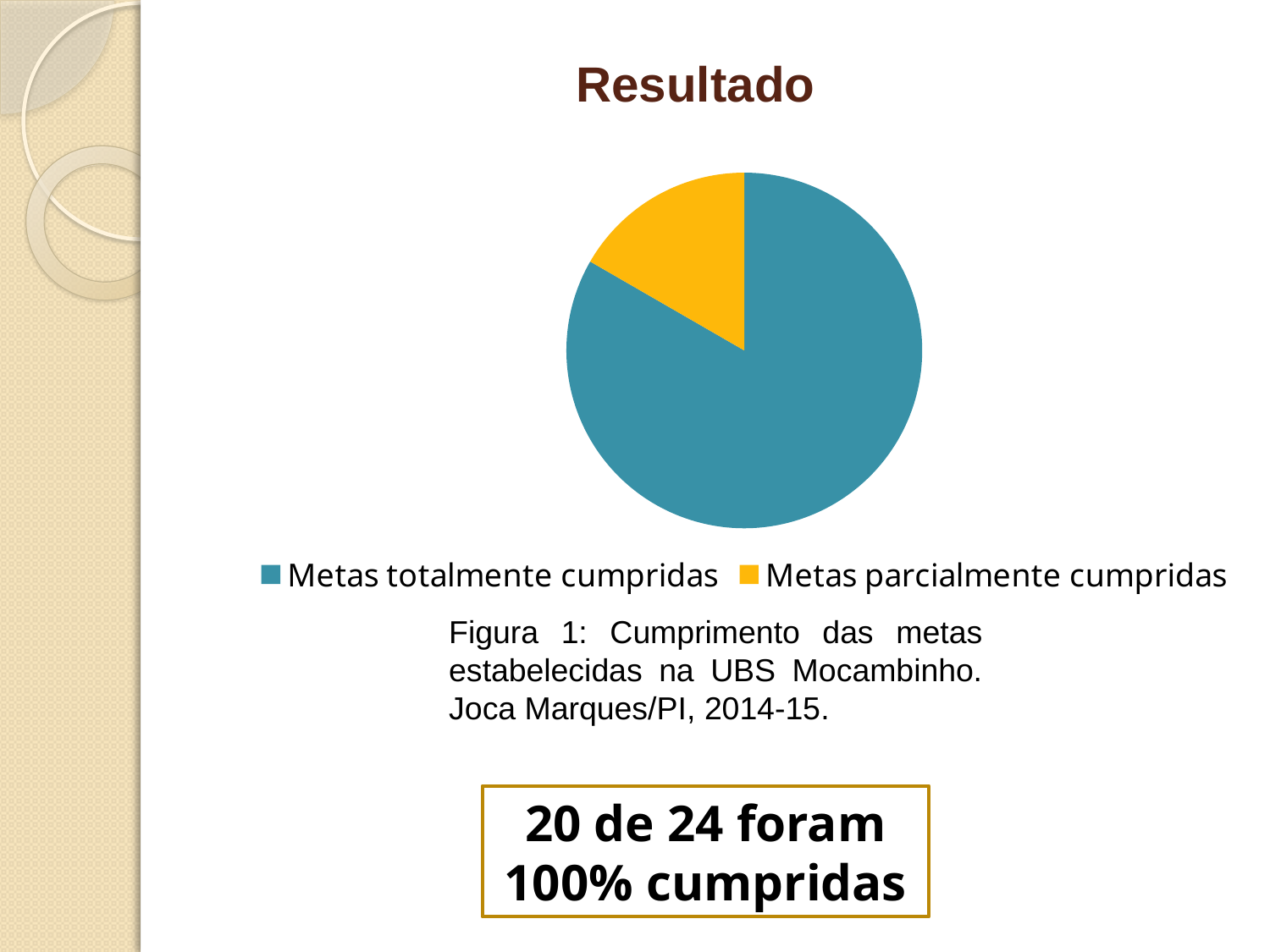
What colour is the slice for Metas totalmente cumpridas? teal What kind of chart is shown on the slide? pie chart What colour is the slice for Metas parcialmente cumpridas? yellow How many entries does the legend of the pie chart list? 2 Which slice is larger: Metas totalmente cumpridas or Metas parcialmente cumpridas? Metas totalmente cumpridas Which category has the smallest slice of the pie chart? Metas parcialmente cumpridas How many slices does the pie chart have? 2 Which category has the largest slice of the pie chart? Metas totalmente cumpridas